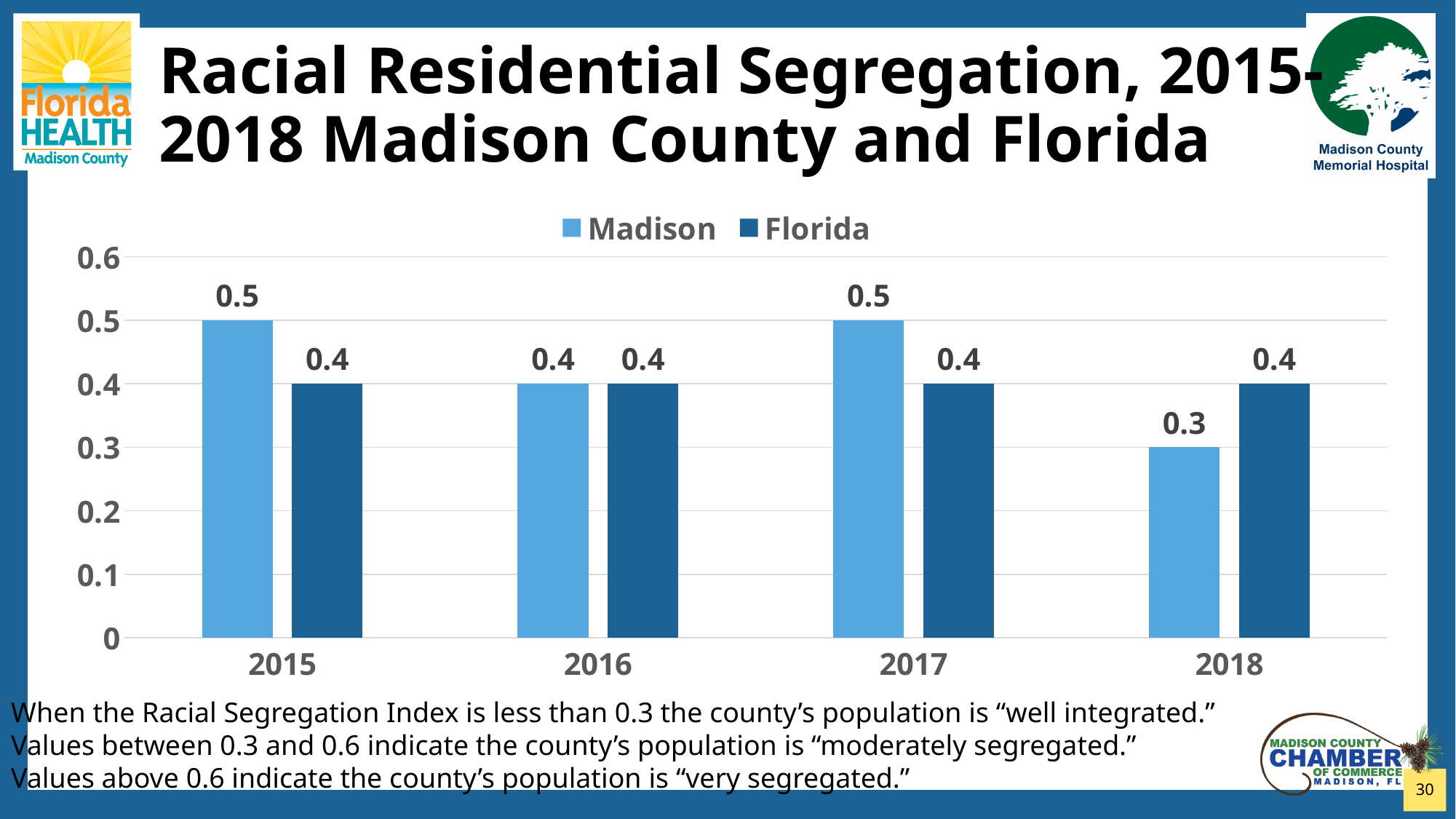
What is the difference between the Madison and Florida values in 2018? 0.1 What is the difference between the Madison and Florida values in 2015? 0.1 In 2018, which is larger, the Madison value or the Florida value? Florida What is the value for Madison in 2015? 0.5 In which year is the Madison value lowest? 2018 How many series does the legend list? 2 What is the value for Madison in 2018? 0.3 What kind of chart is shown on the slide? Bar chart In 2017, which is larger, the Madison value or the Florida value? Madison What is the value for Florida in 2016? 0.4 What is the value for Madison in 2017? 0.5 How many years are shown on the x axis? 4